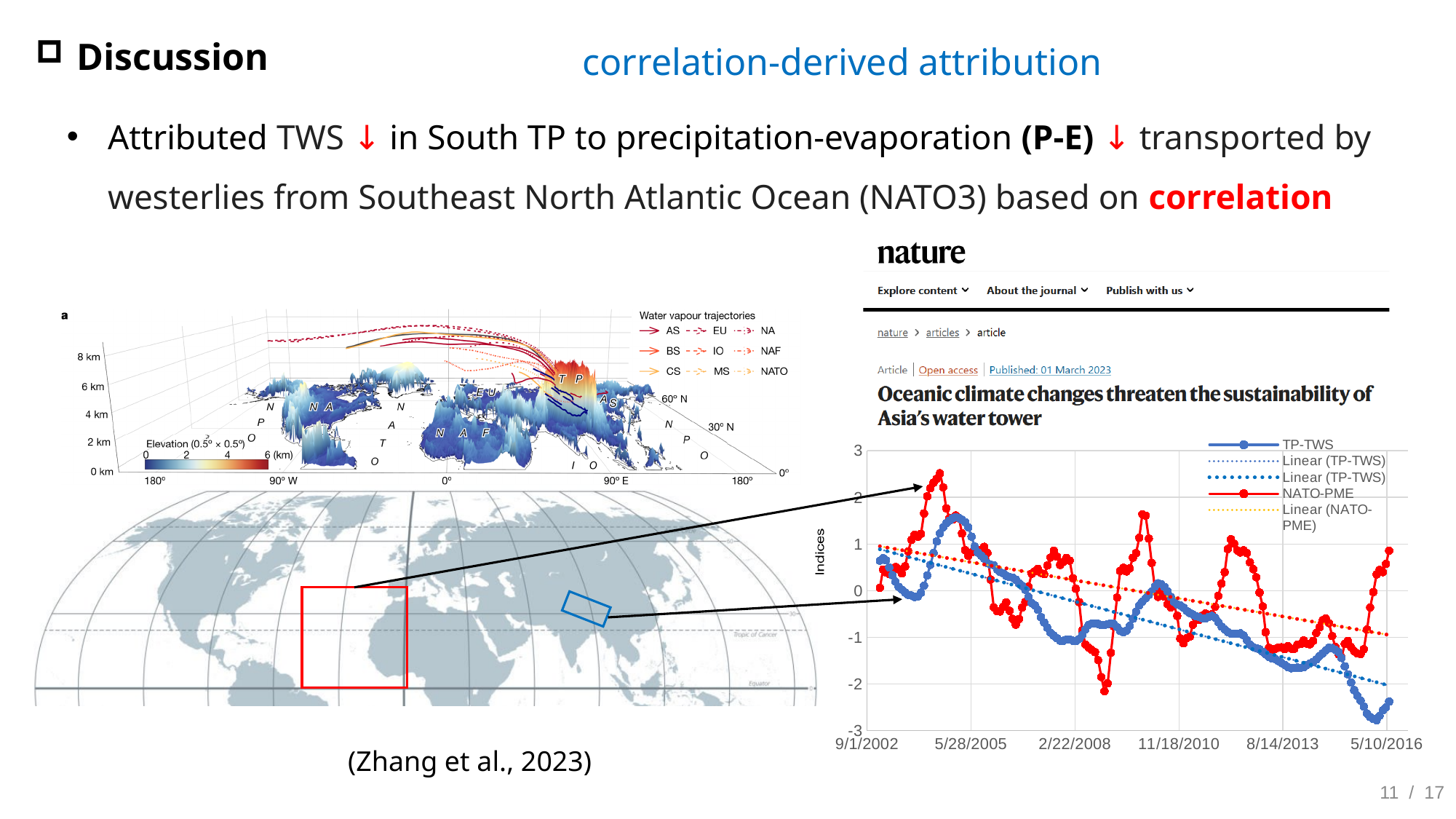
How many date labels are shown along the x axis of the line chart? 6 In the line chart, is the lowest value reached by the TP-TWS series greater or less than -2? less How many entries does the legend of the line chart list? 5 In the line chart, what colour is the NATO-PME series? red What kind of chart is shown on the right side of the slide, below the Nature article header? line chart What is the label on the y axis of the line chart? Indices In the line chart, is the TP-TWS value at 9/1/2002 greater or less than 0? greater In the line chart, does the TP-TWS series overall rise or fall from 9/1/2002 to 5/10/2016? fall In the line chart, near 5/10/2016, which series has the higher value, TP-TWS or NATO-PME? NATO-PME In the line chart, which series reaches the higher peak value, TP-TWS or NATO-PME? NATO-PME In the line chart, is the highest value reached by the NATO-PME series greater or less than 2? greater In the line chart, does the Linear (NATO-PME) trend line rise or fall along the x axis? fall